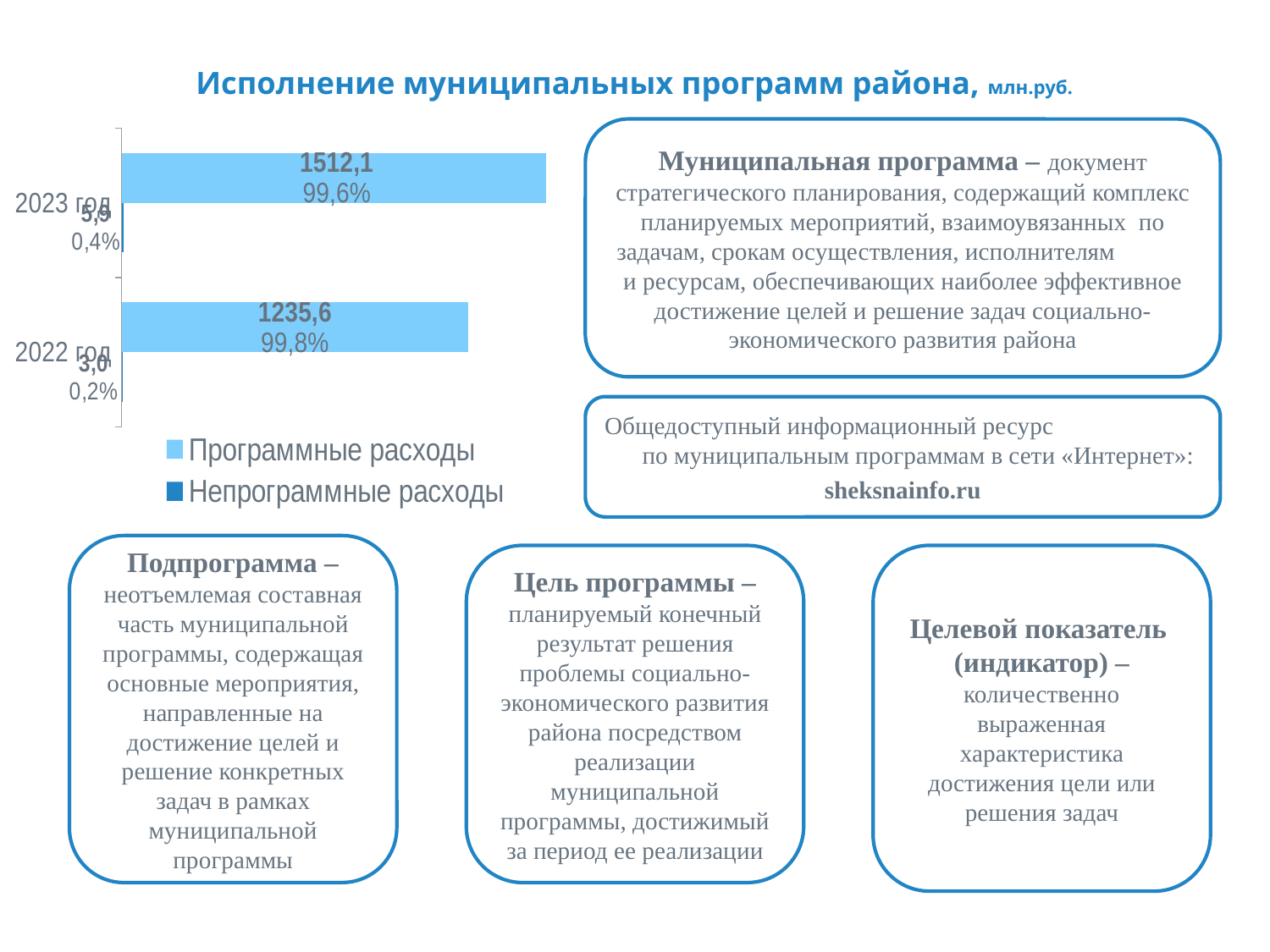
How many series does the legend list? 2 What is the value of Программные расходы for 2022 год? 1235,6 What is the title of the chart? Исполнение муниципальных программ района, млн.руб. By how much did Программные расходы in 2023 год exceed those in 2022 год? 276,5 What is the value of Непрограммные расходы for 2022 год? 3,0 What percentage share is shown for Непрограммные расходы in 2023 год? 0,4% What is the value of Программные расходы for 2023 год? 1512,1 What percentage share is shown for Программные расходы in 2022 год? 99,8% What type of chart is shown on the slide? bar chart What percentage share is shown for Непрограммные расходы in 2022 год? 0,2% Which year has the higher value of Программные расходы, 2022 год or 2023 год? 2023 год What percentage share is shown for Программные расходы in 2023 год? 99,6%